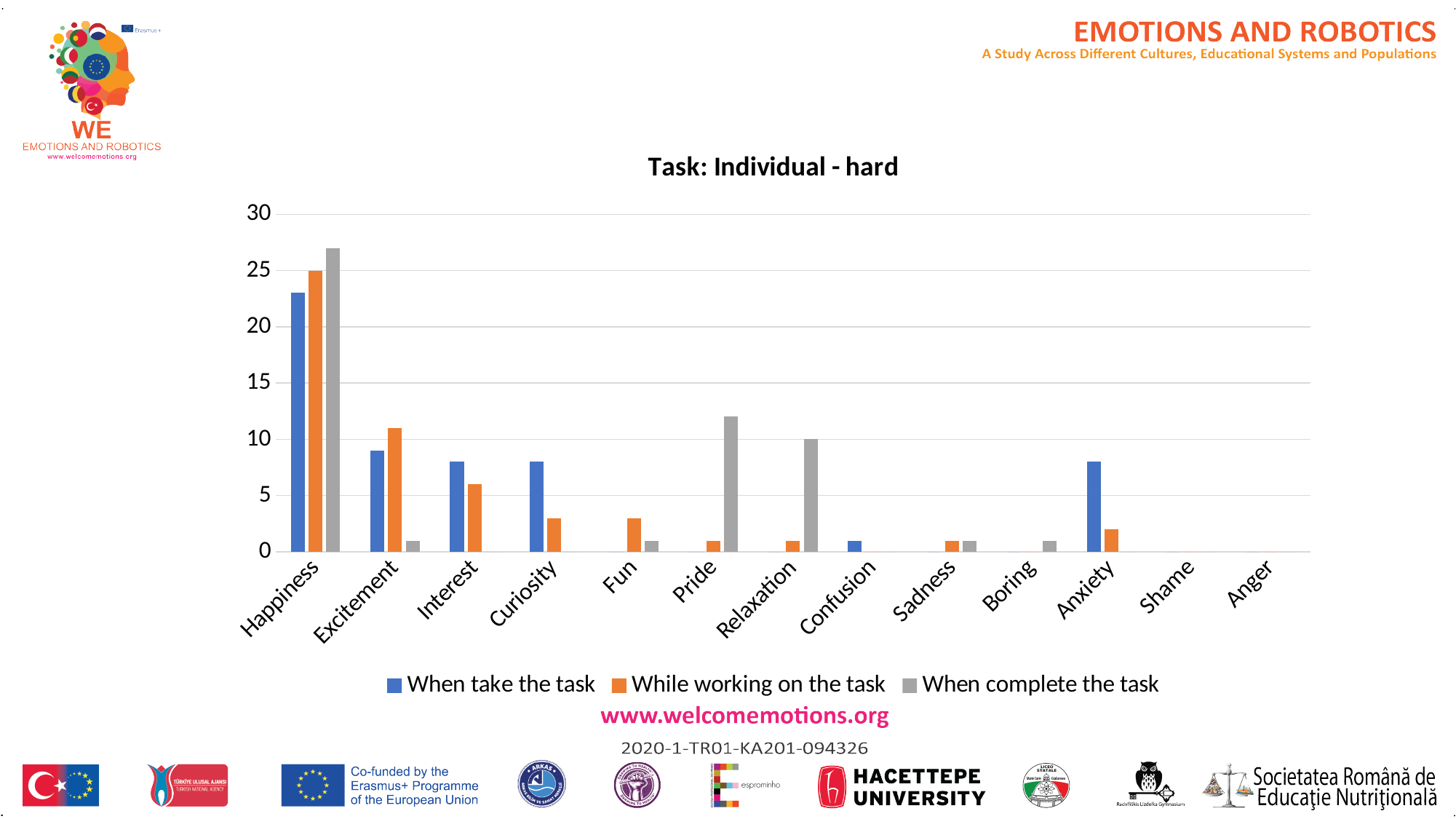
How many emotion categories are shown on the x axis? 13 In the 'When complete the task' series, which is larger: Pride or Relaxation? Pride Is the value for Pride in the 'When complete the task' series greater or less than 10? greater What is the value for Happiness in the 'While working on the task' series? 25 What kind of chart is shown on the slide? bar chart Is the value for Anxiety in the 'When take the task' series greater or less than 5? greater Is the value for Happiness in the 'When take the task' series greater or less than 20? greater Which colour represents the 'When take the task' series? blue What is the title of the chart? Task: Individual - hard What is the value for Relaxation in the 'When complete the task' series? 10 Which emotion has the highest value in the 'When complete the task' series? Happiness How many series does the legend list? 3